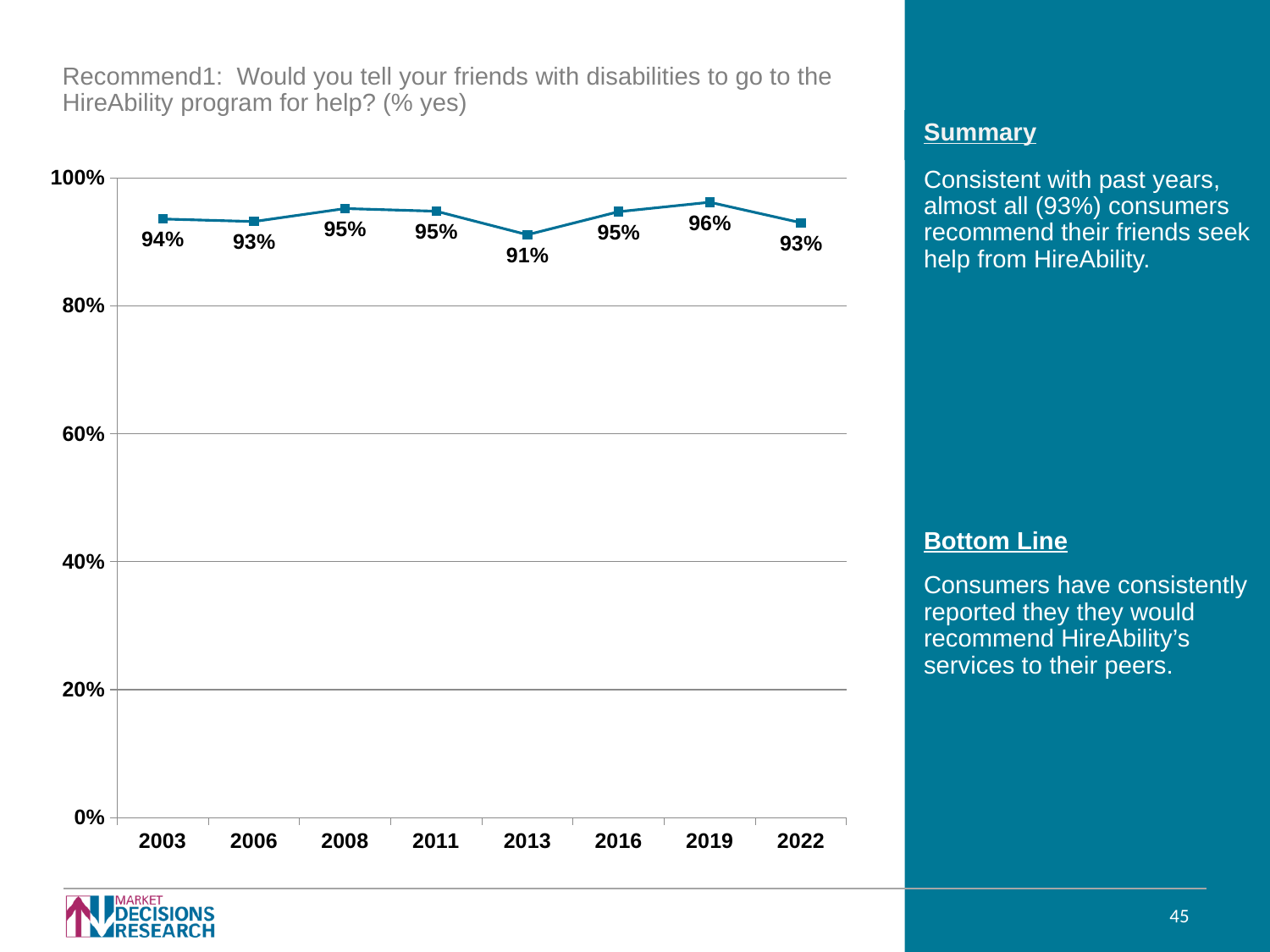
What value is shown for 2003? 94% How many years are plotted on the chart? 8 Which year has the highest value? 2019 What is the difference between the 2019 value and the 2013 value? 5% Which is larger, the value for 2008 or the value for 2013? 2008 What is the highest value labelled on the y axis? 100% Which year has the lowest value? 2013 Is the value for 2016 greater or less than 80%? greater What value is shown for 2013? 91% What percentage of consumers said yes in 2022? 93% What kind of chart is shown? line chart Does the value rise or fall from 2019 to 2022? fall